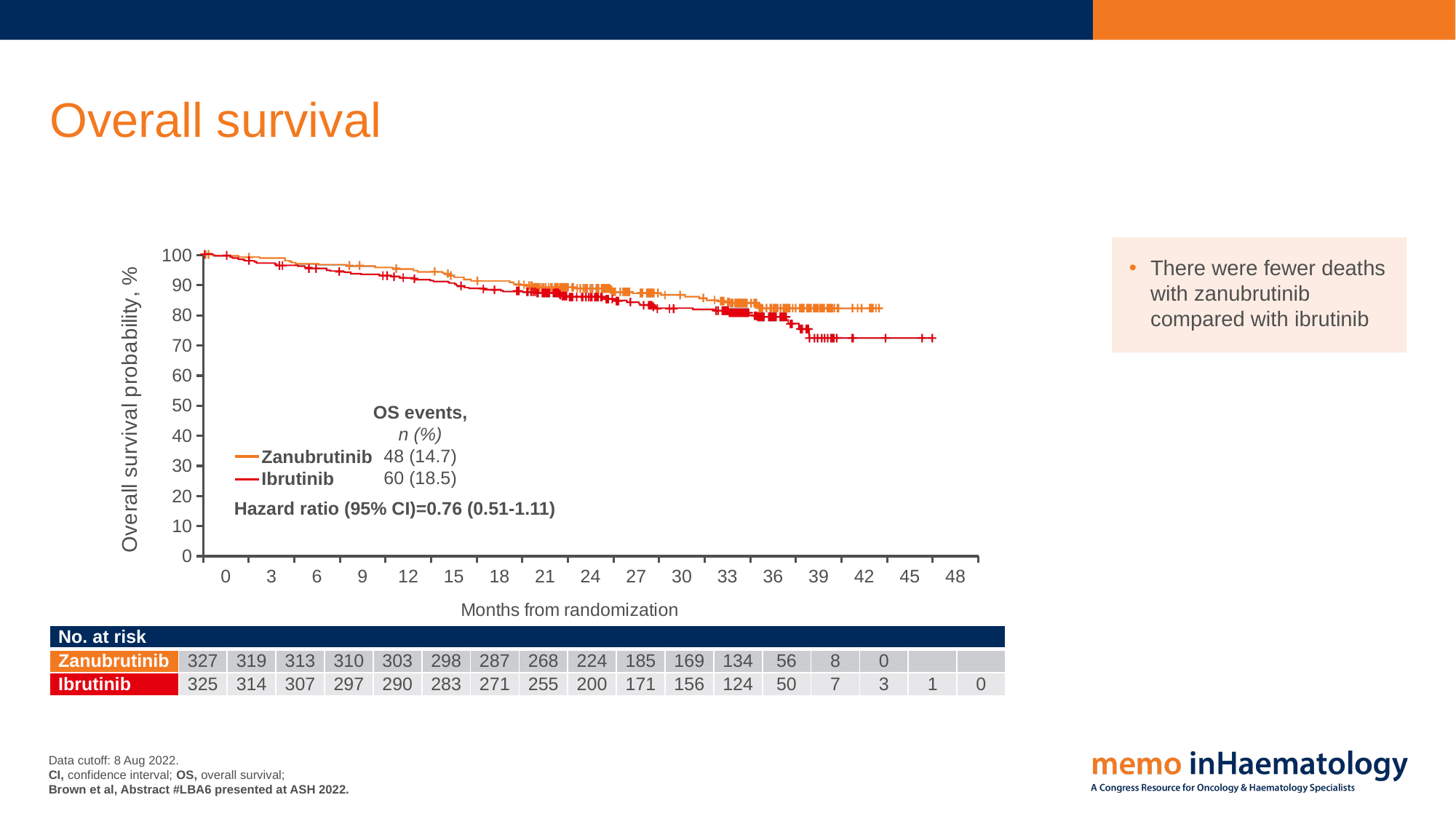
In the No. at risk table, how many zanubrutinib patients were at risk at month 0? 327 How many OS events, n (%), are reported for ibrutinib? 60 (18.5) What is the difference in the number of OS events between ibrutinib and zanubrutinib? 12 How many series (treatment arms) does the chart legend list? 2 Which treatment arm had more OS events, zanubrutinib or ibrutinib? Ibrutinib How many OS events, n (%), are reported for zanubrutinib? 48 (14.7) What is the label of the x axis? Months from randomization In the No. at risk table, how many ibrutinib patients were at risk at month 0? 325 What kind of chart is shown on the slide? line chart Is the overall survival probability for ibrutinib at 45 months greater or less than 80%? less What is the hazard ratio (95% CI) shown on the chart? 0.76 (0.51-1.11) Is the overall survival probability for zanubrutinib at 42 months greater or less than 80%? greater